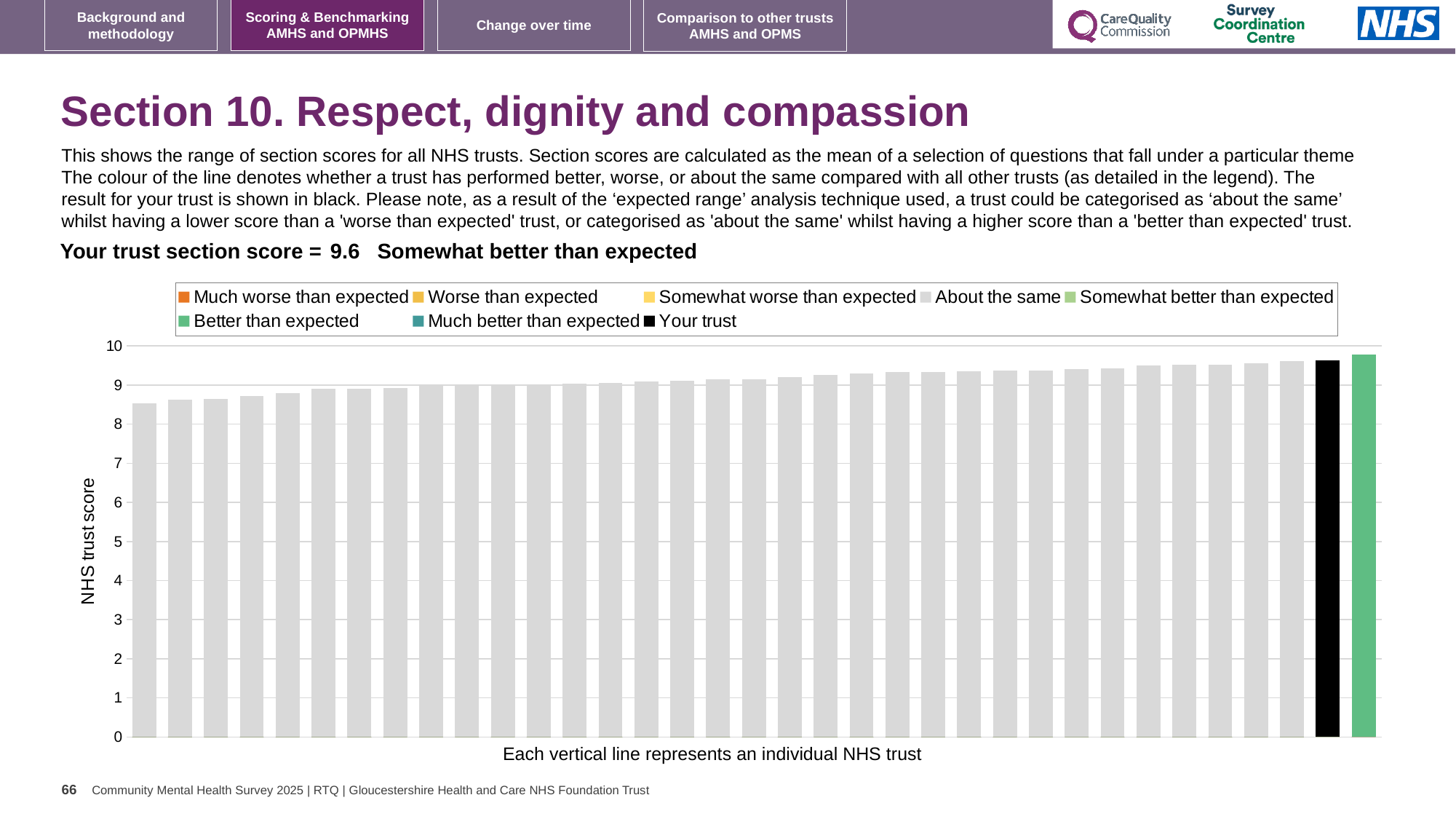
Is the value of the leftmost (lowest) bar greater or less than 8? greater How many bars in the chart are coloured something other than grey? 2 What is the highest value shown on the vertical axis? 10 What is the label on the vertical axis of the chart? NHS trust score Is the value of the leftmost (lowest) bar greater or less than 9? less How many entries does the chart legend list? 8 Is the value of the black 'Your trust' bar greater or less than 9? greater What colour is the bar representing your trust? black Which performance category is your trust placed in for Section 10? Somewhat better than expected What kind of chart is shown on the slide? bar chart What is the section score for your trust shown on the slide? 9.6 Do the bar values rise or fall from left to right along the x axis? rise